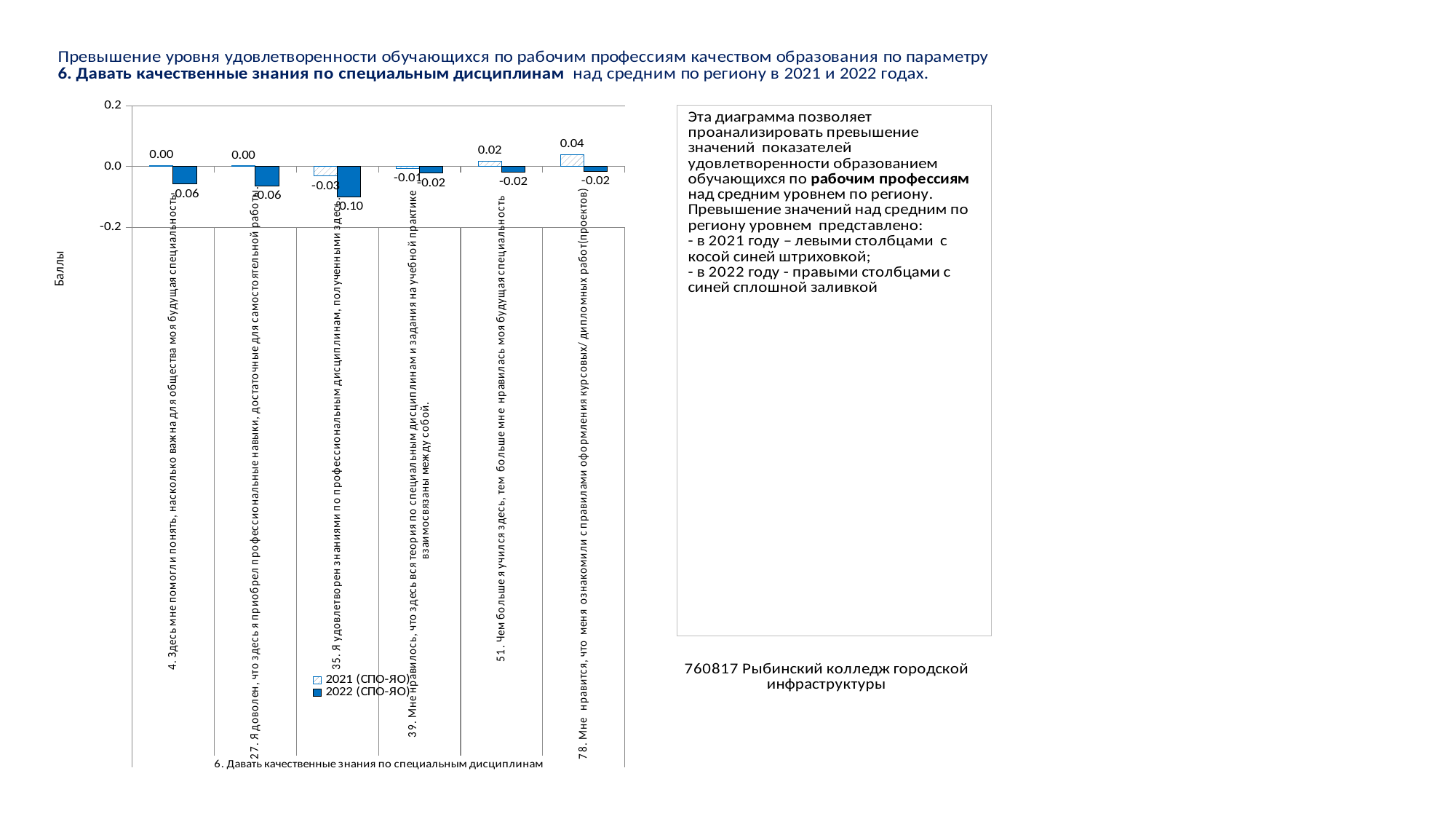
What is the 2021 (СПО-ЯО) value for category 51 (Чем больше я учился здесь, тем больше мне нравилась моя будущая специальность)? 0.02 For category 78, which series has the larger value, 2021 (СПО-ЯО) or 2022 (СПО-ЯО)? 2021 (СПО-ЯО) How many categories (questions) are plotted on the chart? 6 What kind of chart is shown on the slide? bar chart What is the 2021 (СПО-ЯО) value for category 78 (Мне нравится, что меня ознакомили с правилами оформления курсовых/дипломных работ)? 0.04 How many series does the chart legend list? 2 What is the 2022 (СПО-ЯО) value for category 4 (Здесь мне помогли понять, насколько важна для общества моя будущая специальность)? -0.06 What is the label of the vertical axis of the chart? Баллы Which category has the lowest 2022 (СПО-ЯО) value? 35. Я удовлетворен знаниями по профессиональным дисциплинам, полученными здесь What is the 2022 (СПО-ЯО) value for category 35 (Я удовлетворен знаниями по профессиональным дисциплинам)? -0.10 What is the difference between the 2021 and 2022 values for category 35? 0.07 Which category has the highest 2021 (СПО-ЯО) value? 78. Мне нравится, что меня ознакомили с правилами оформления курсовых/дипломных работ(проектов)